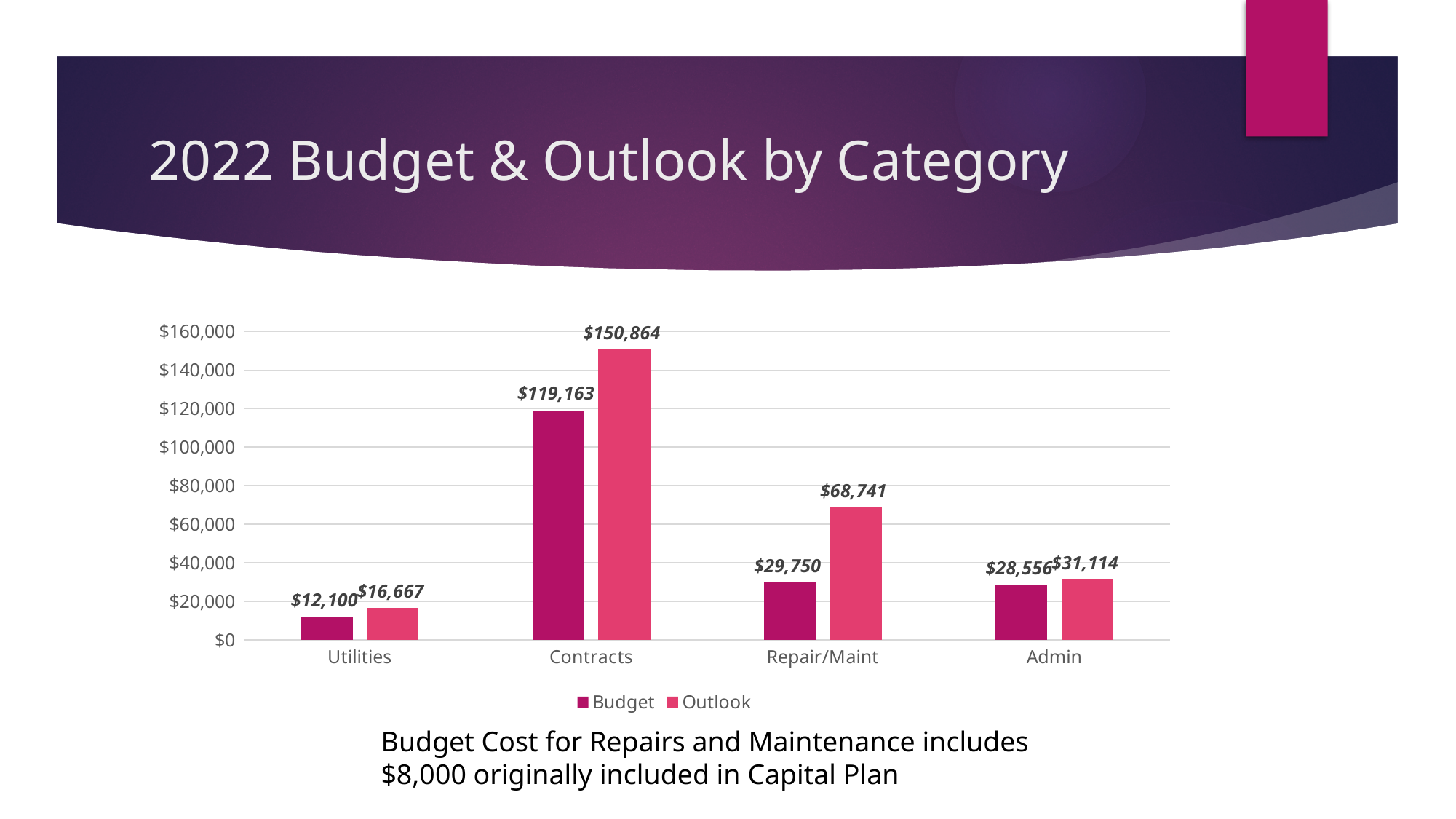
What kind of chart is shown on the slide? Bar chart How many categories are shown on the x axis? 4 What is the Outlook value for Admin? $31,114 Which is larger, the Budget value for Repair/Maint or the Budget value for Admin? Repair/Maint What is the difference between the Outlook and Budget values for Repair/Maint? $38,991 What is the Outlook value for Repair/Maint? $68,741 Which category has the lowest Budget value? Utilities What is the Budget value for Utilities? $12,100 What is the difference between the Outlook and Budget values for Contracts? $31,701 Which category has the highest Outlook value? Contracts What is the Budget value for Contracts? $119,163 How many series does the legend list? 2